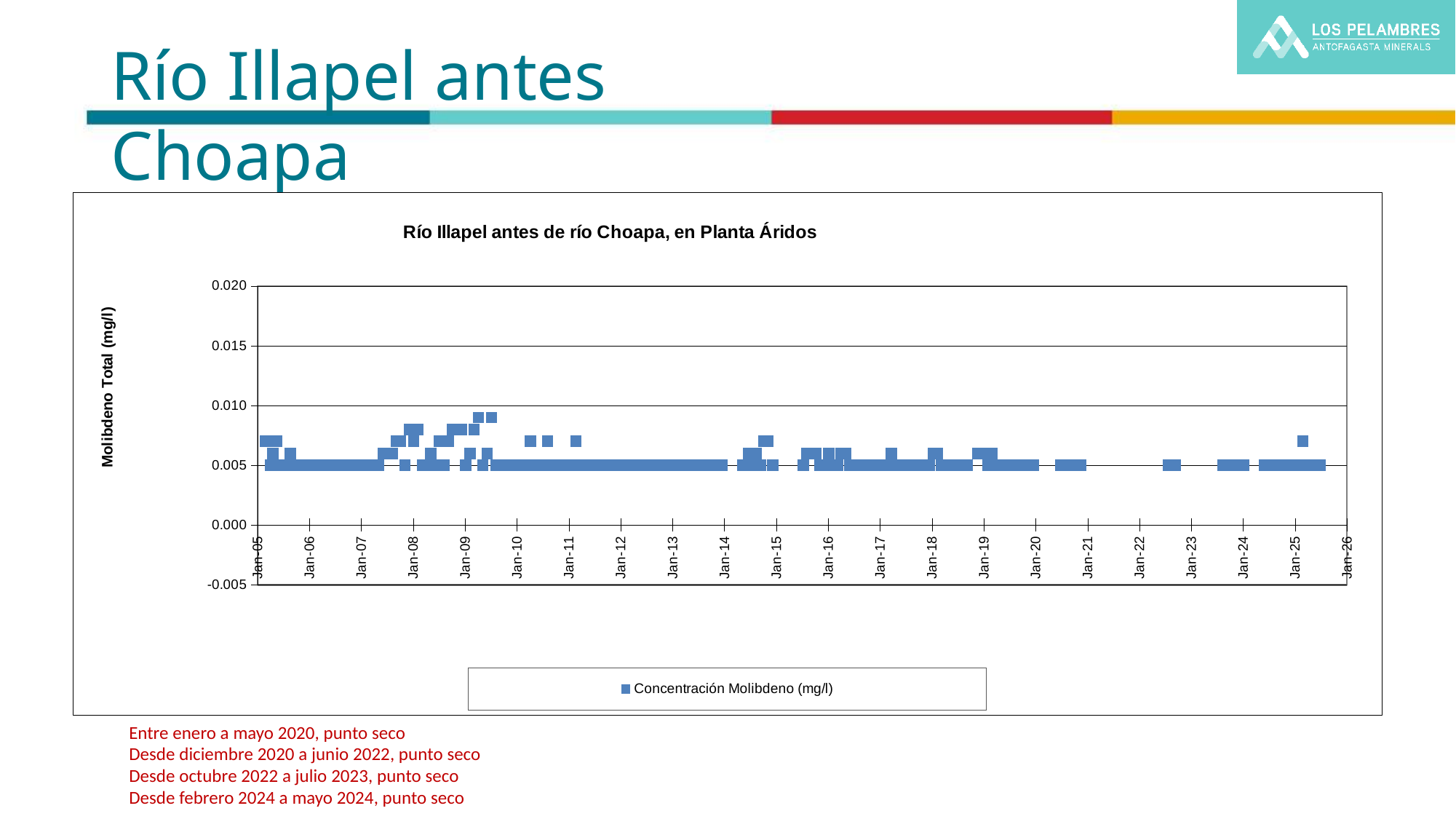
Are the values plotted around Jan-25 greater or less than 0.015? less Do the plotted values show a clear rising trend from Jan-05 to Jan-26? no In which year do the highest plotted points occur? 2009 Is the highest plotted value greater or less than 0.010? less What is the title of the chart? Río Illapel antes de río Choapa, en Planta Áridos Is the highest plotted value greater or less than 0.005? greater How many series does the legend list? 1 What is the legend entry for the plotted series? Concentración Molibdeno (mg/l) What kind of chart is shown on the slide? scatter chart